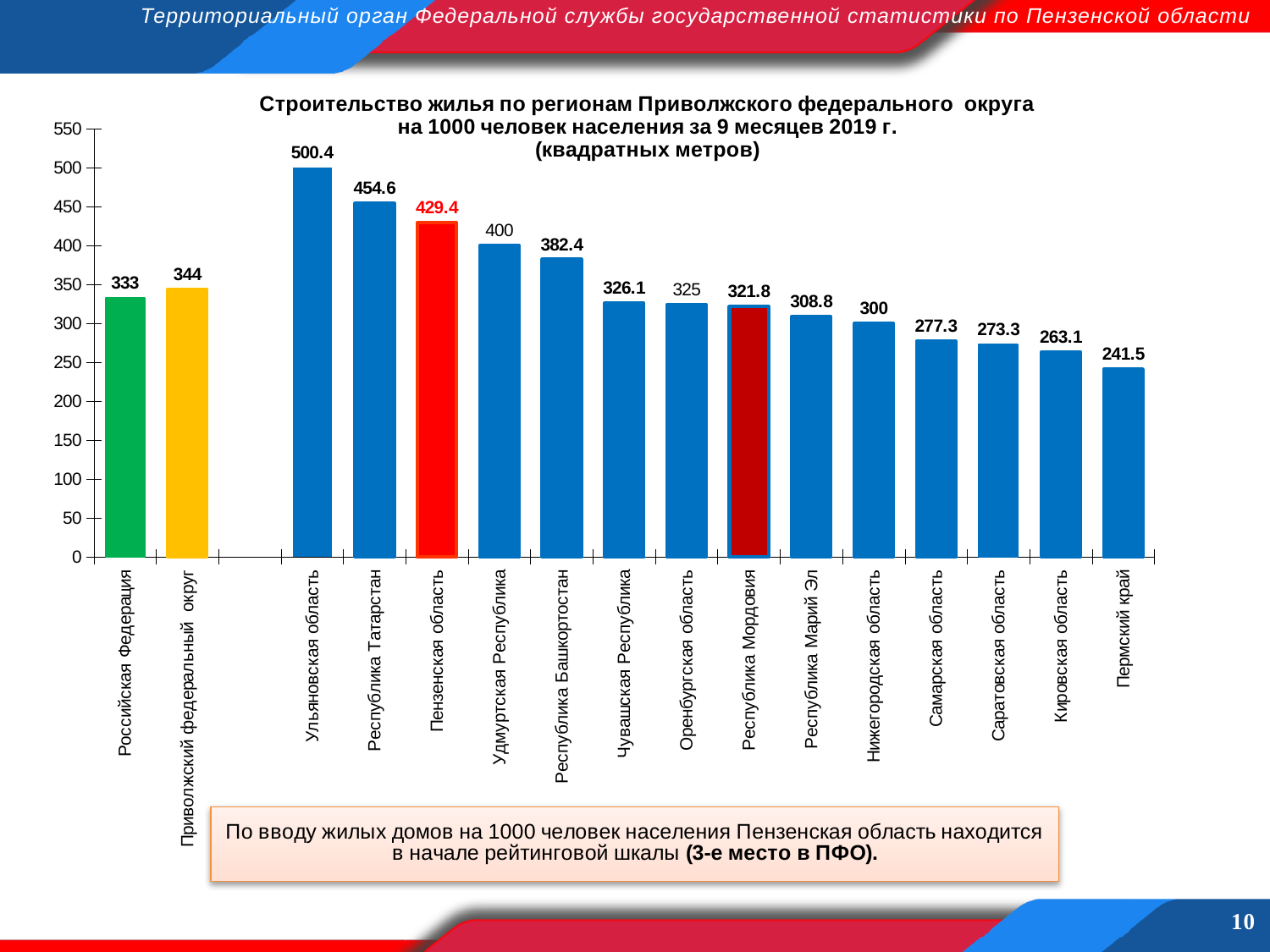
What is the value for Республика Татарстан? 454.6 What is the value for Пензенская область? 429.4 Which category has the lowest value? Пермский край Which is larger, the value for Приволжский федеральный округ or the value for Российская Федерация? Приволжский федеральный округ How many bars are plotted on the chart? 16 What kind of chart is shown on the slide? bar chart What is the value for Пермский край? 241.5 Do the values rise or fall from Ульяновская область to Пермский край along the x axis? fall Which region has the highest value? Ульяновская область What is the difference between the values for Ульяновская область and Пензенская область? 71 What is the value for Российская Федерация? 333 What colour is the bar for Пензенская область? red